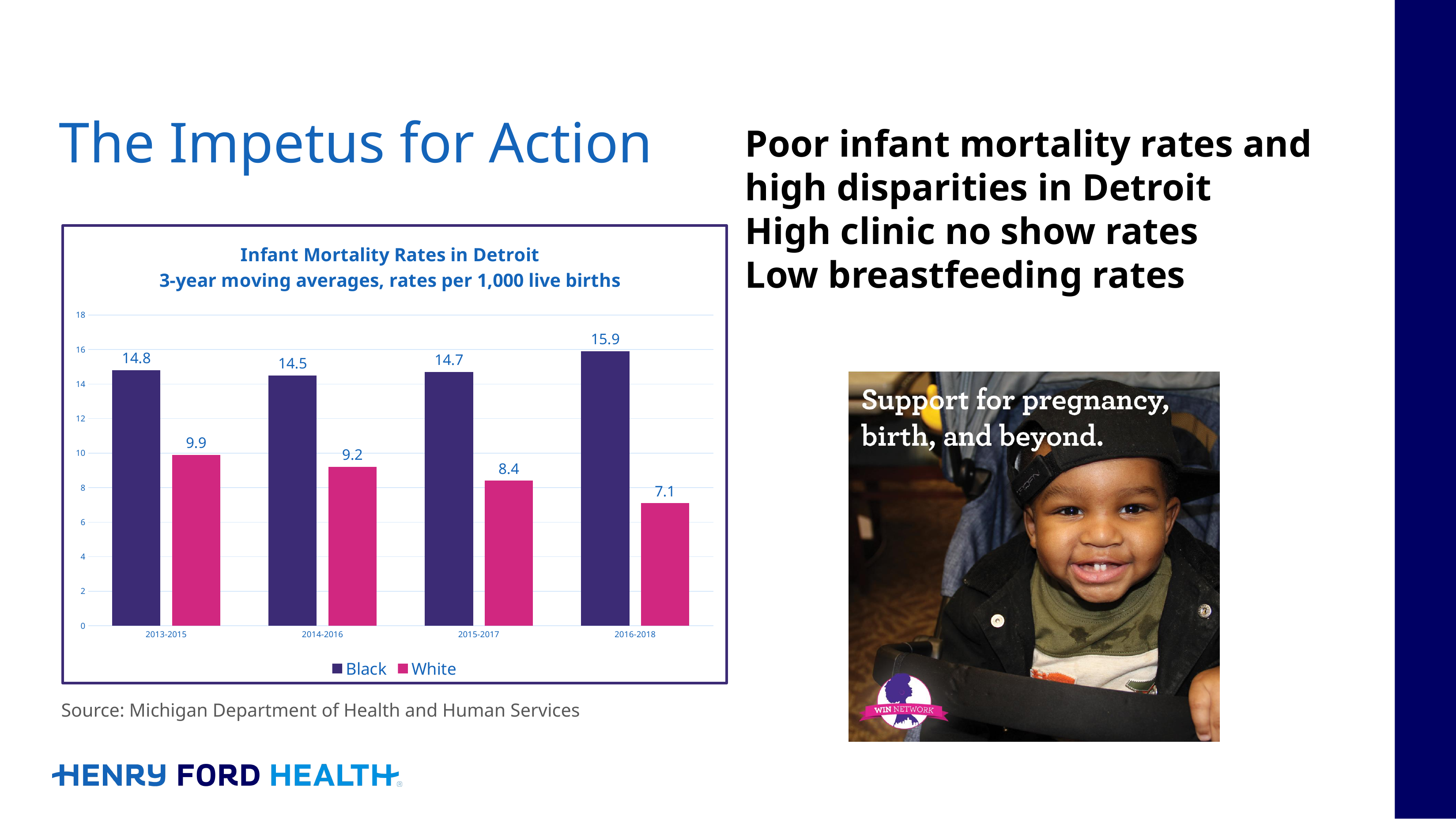
How many series does the legend list? 2 In which period is the White infant mortality rate lowest? 2016-2018 Which is larger, the White rate in 2013-2015 or the White rate in 2015-2017? 2013-2015 What kind of chart is shown on the slide? Bar chart Does the White infant mortality rate rise or fall across the periods from 2013-2015 to 2016-2018? Fall In which period is the Black infant mortality rate highest? 2016-2018 What is the infant mortality rate for Black infants in 2013-2015? 14.8 How many time periods are shown on the x axis? 4 What is the infant mortality rate for White infants in 2014-2016? 9.2 What is the difference between the Black and White infant mortality rates in 2016-2018? 8.8 What is the infant mortality rate for White infants in 2016-2018? 7.1 What is the difference between the Black and White infant mortality rates in 2013-2015? 4.9